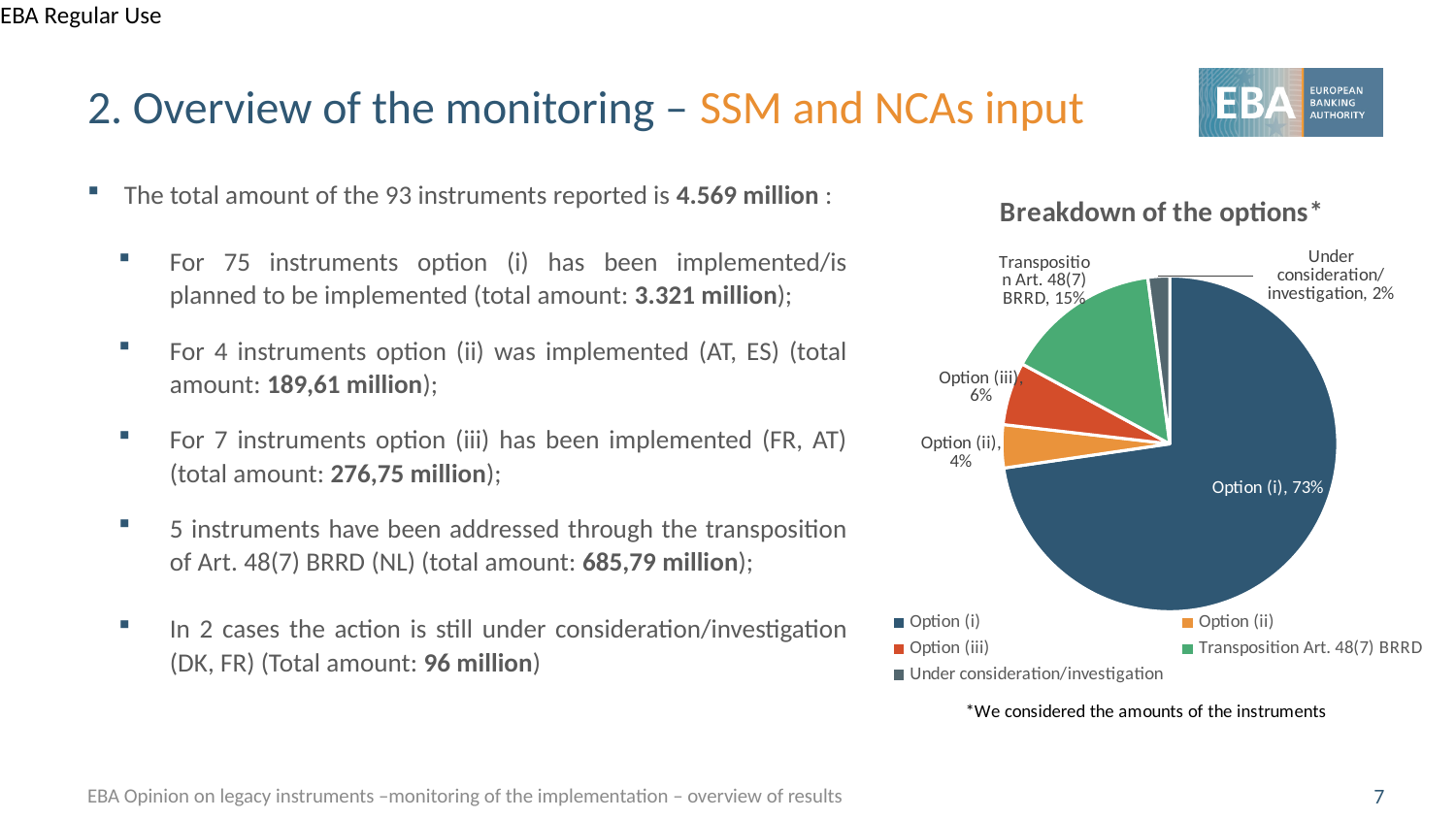
What kind of chart is shown on the slide? pie chart What is the difference in percentage points between Option (i) and Transposition Art. 48(7) BRRD? 58 What share of the pie does Option (ii) represent? 4% Which slice of the pie is the smallest? Under consideration/investigation What share of the pie does Transposition Art. 48(7) BRRD represent? 15% How many slices does the pie chart have? 5 What share of the pie does Under consideration/investigation represent? 2% Which is larger, the share for Option (iii) or the share for Option (ii)? Option (iii) What is the title of the chart? Breakdown of the options* Which slice of the pie is the largest? Option (i)